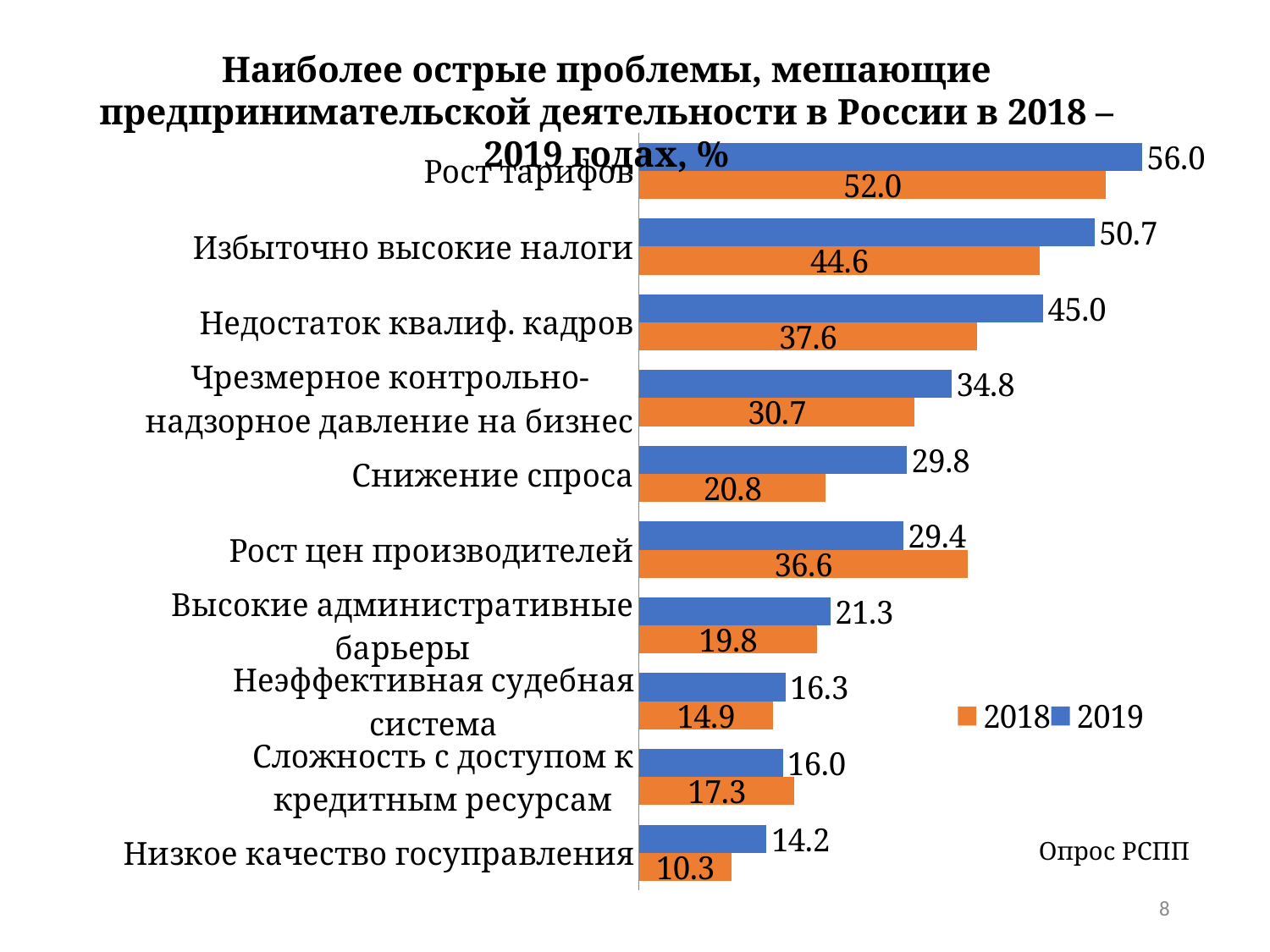
What is the difference between the 2019 and 2018 values for Снижение спроса? 9.0 What kind of chart is shown on the slide? Bar chart Which category has the lowest 2018 value? Низкое качество госуправления What is the 2018 value for Рост цен производителей? 36.6 Which colour represents the 2018 series in the chart? Orange What is the 2018 value for Избыточно высокие налоги? 44.6 What is the 2019 value for Рост тарифов? 56.0 For Сложность с доступом к кредитным ресурсам, which year has the larger value, 2018 or 2019? 2018 Which category has the highest 2019 value? Рост тарифов How many categories (problems) are shown in the chart? 10 What is the 2019 value for Низкое качество госуправления? 14.2 How many series does the legend list? 2